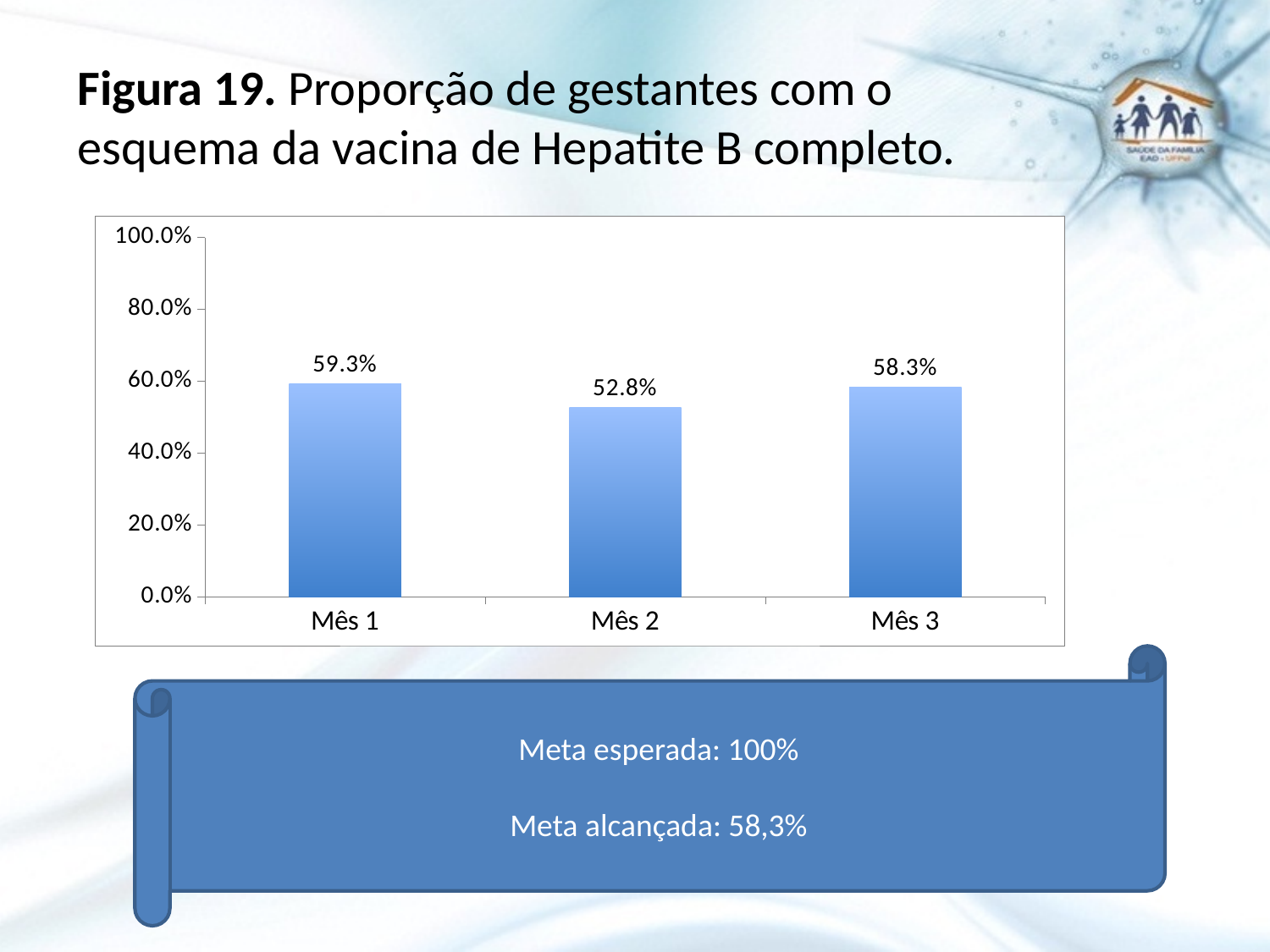
What is the value for Mês 3? 58.3% Which is larger, the value for Mês 2 or the value for Mês 3? Mês 3 What kind of chart is shown on the slide? bar chart What is the value for Mês 2? 52.8% What is the value for Mês 1? 59.3% What is the highest value shown on the y axis? 100.0% What is the difference between the values for Mês 1 and Mês 2? 6.5% Which month has the highest value? Mês 1 Is the value for Mês 2 greater or less than 60.0%? less How many months are shown on the x axis? 3 Which month has the lowest value? Mês 2 What is the difference between the values for Mês 3 and Mês 2? 5.5%